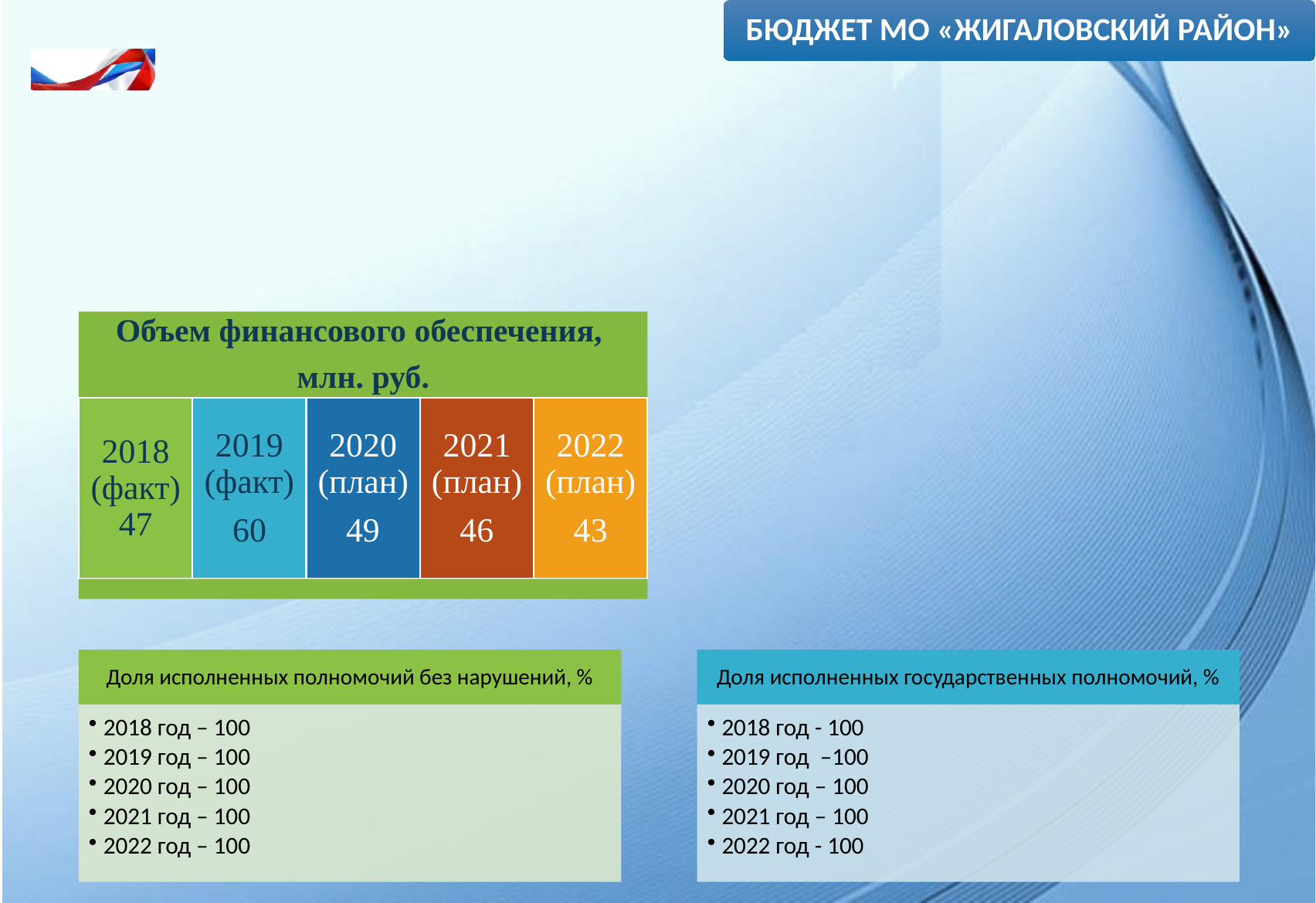
In the "Объем финансового обеспечения, млн. руб." graphic, what is the value for 2019 (факт)? 60 In the "Доля исполненных полномочий без нарушений, %" box, what is the value for 2020 год? 100 In the "Объем финансового обеспечения, млн. руб." graphic, what is the difference between the 2019 (факт) and 2018 (факт) values? 13 In the "Объем финансового обеспечения, млн. руб." graphic, what is the value for 2022 (план)? 43 In the "Объем финансового обеспечения, млн. руб." graphic, what is the difference between the 2020 (план) and 2022 (план) values? 6 How many years are shown in the "Объем финансового обеспечения, млн. руб." graphic? 5 In the "Объем финансового обеспечения, млн. руб." graphic, do the values rise or fall from 2020 (план) to 2022 (план)? fall In the "Объем финансового обеспечения, млн. руб." graphic, what colour is the 2021 (план) block? Orange-brown In the "Объем финансового обеспечения, млн. руб." graphic, which is larger: the value for 2020 (план) or 2021 (план)? 2020 (план) In the "Объем финансового обеспечения, млн. руб." graphic, what is the value for 2018 (факт)? 47 In the "Объем финансового обеспечения, млн. руб." graphic, which year has the highest value? 2019 (факт) In the "Объем финансового обеспечения, млн. руб." graphic, which year has the lowest value? 2022 (план)